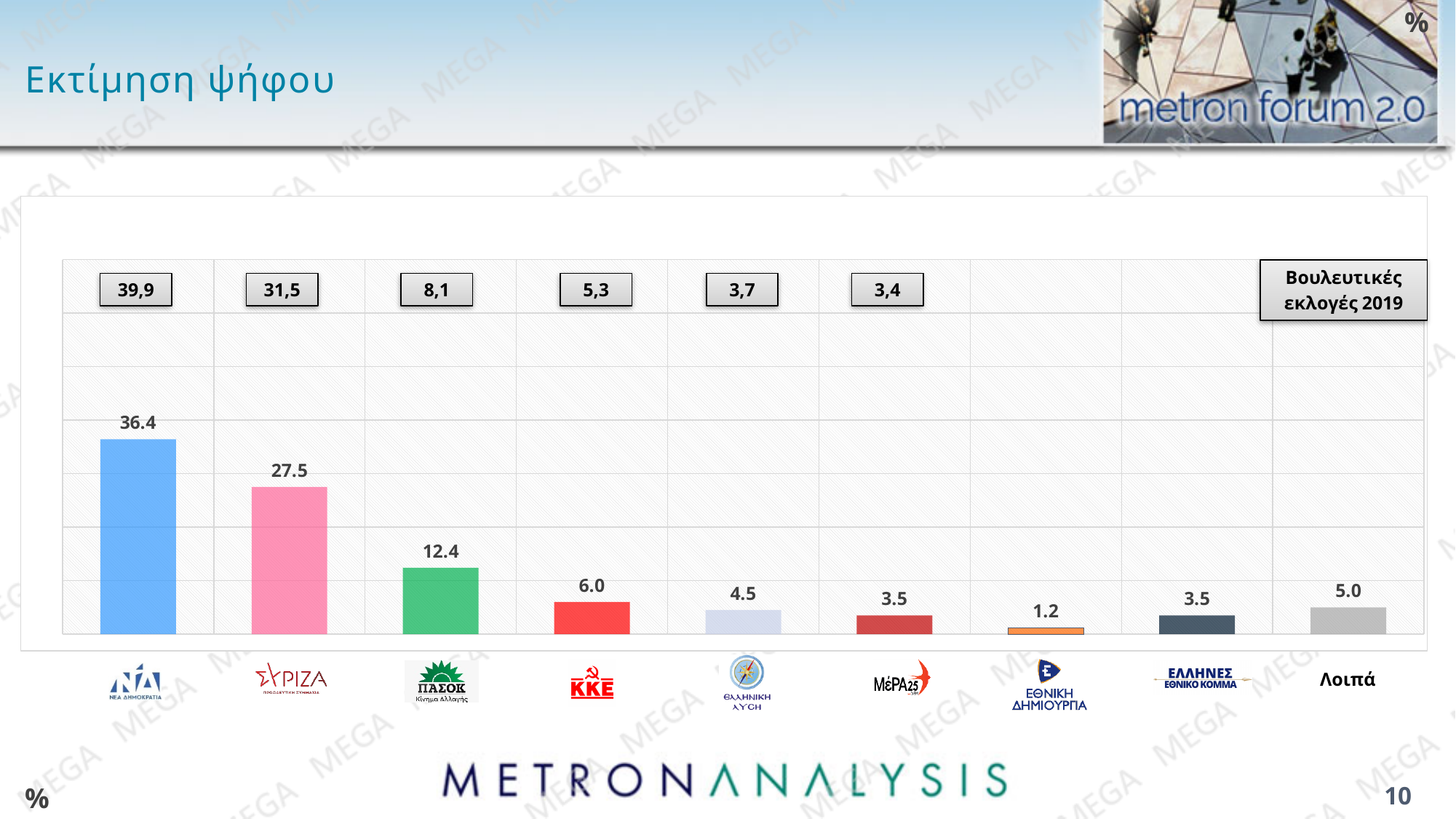
What 2019 parliamentary election result (Βουλευτικές εκλογές 2019) is shown in the box above the ΣΥΡΙΖΑ bar? 31,5 What value is shown for ΠΑΣΟΚ? 12.4 Which is larger, the value for ΚΚΕ or the value for ΕΛΛΗΝΙΚΗ ΛΥΣΗ? ΚΚΕ What is the difference between the values for ΝΕΑ ΔΗΜΟΚΡΑΤΙΑ and ΣΥΡΙΖΑ? 8.9 What is the estimated vote share shown for ΝΕΑ ΔΗΜΟΚΡΑΤΙΑ (ΝΔ)? 36.4 What is the estimated vote share shown for ΣΥΡΙΖΑ? 27.5 Which party has the highest estimated vote share? ΝΕΑ ΔΗΜΟΚΡΑΤΙΑ What value is shown for Λοιπά? 5.0 What value is shown for ΚΚΕ? 6.0 Which party has the lowest estimated vote share? ΕΘΝΙΚΗ ΔΗΜΙΟΥΡΓΙΑ How many bars are plotted in the chart? 9 What kind of chart is shown on the slide? Bar chart